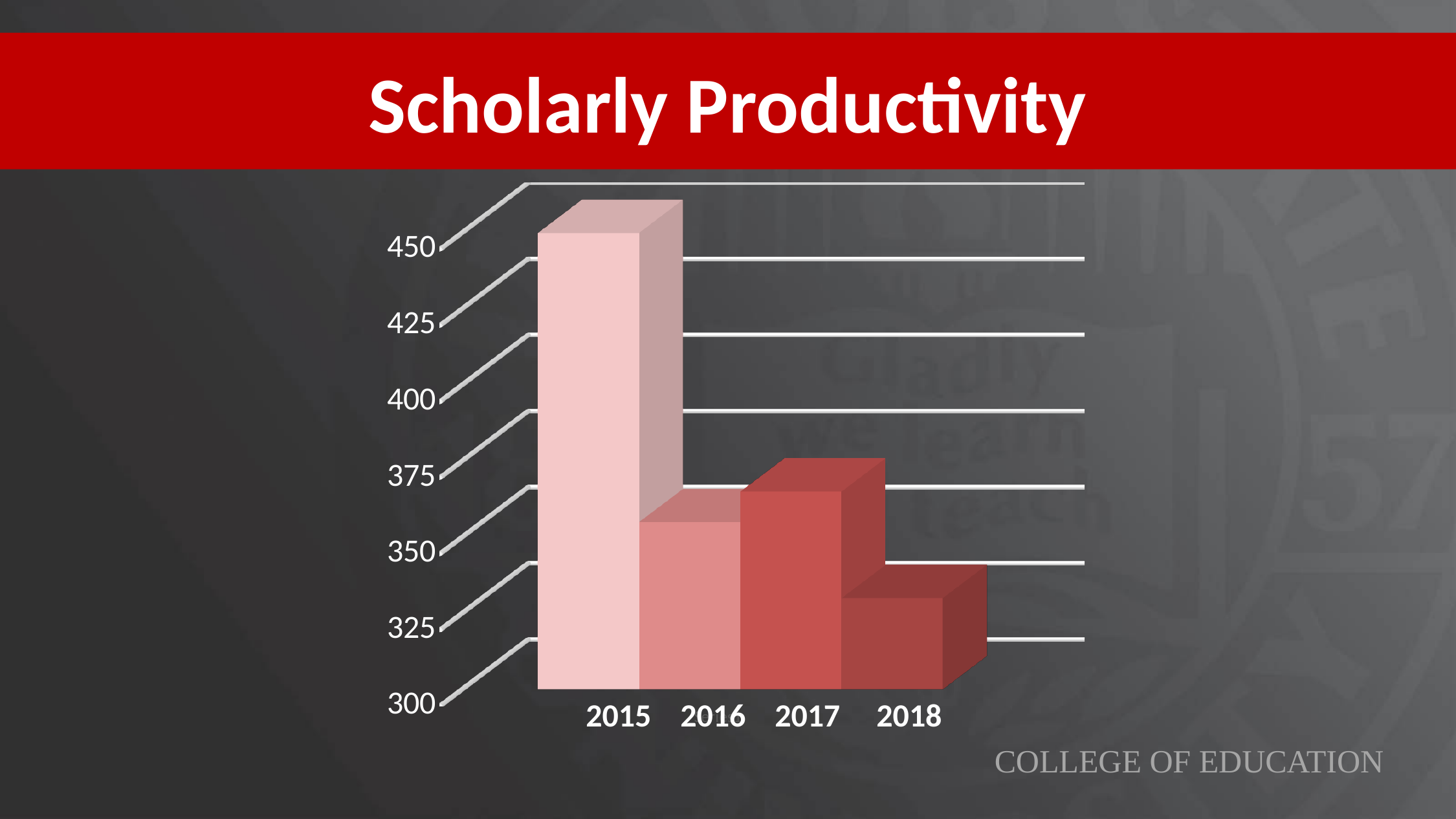
Is the value for 2017 greater or less than 350? greater Which year has the highest value in the chart? 2015 What is the title of the chart on the slide? Scholarly Productivity Is the value for 2016 greater or less than 375? less Is the value for 2015 greater or less than 400? greater Which year has the lowest value in the chart? 2018 Which year has the larger value, 2015 or 2018? 2015 Does the value fall or rise from 2017 to 2018? fall How many years are shown on the x axis of the chart? 4 What kind of chart is shown on the slide? bar chart Which year has the larger value, 2016 or 2017? 2017